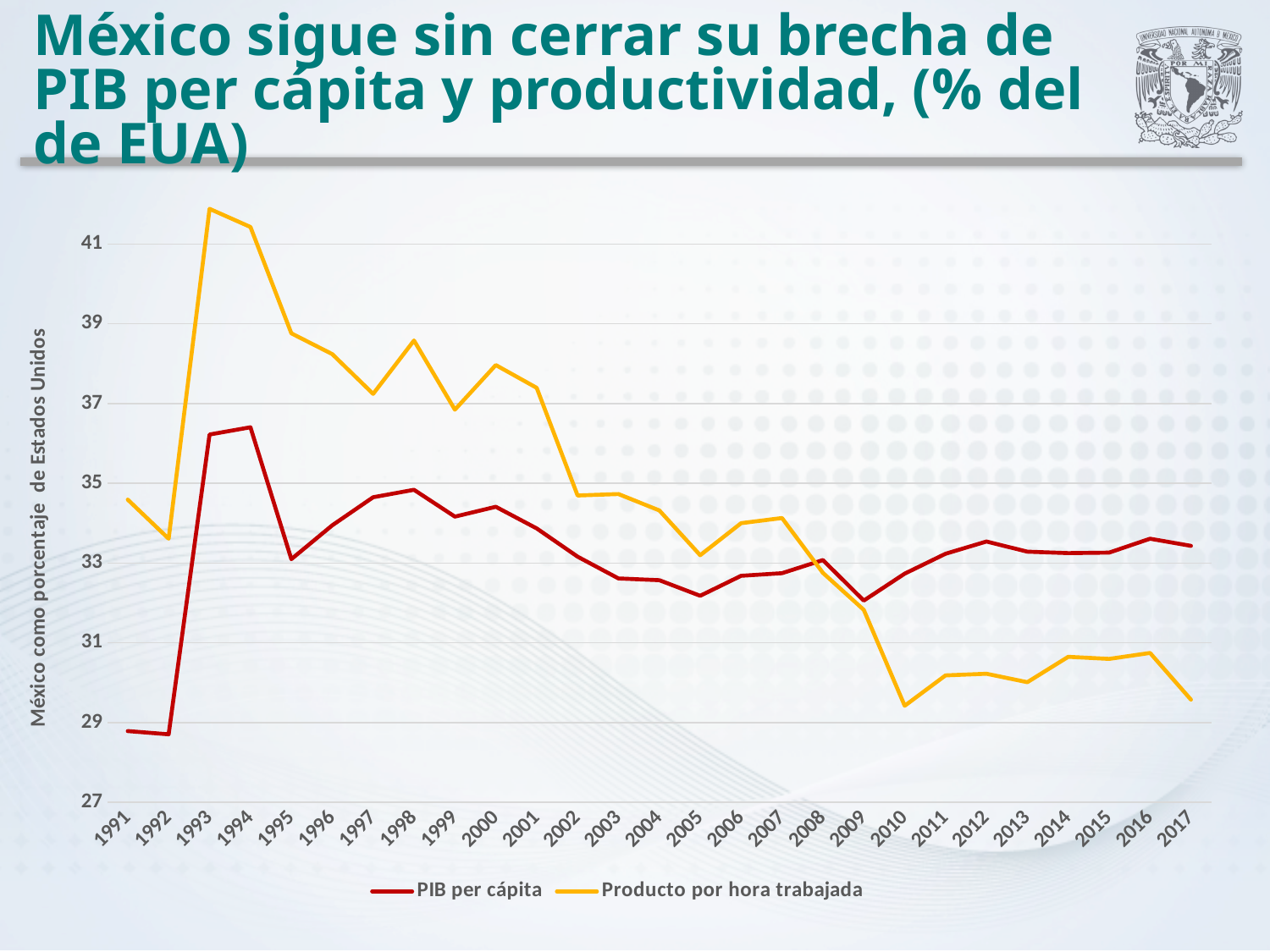
How many years are plotted along the x axis? 27 Is the value of PIB per cápita in 1991 greater or less than 29? less What kind of chart is shown on the slide? line chart How many series does the legend list? 2 Which colour is used for the PIB per cápita series? red Is the value of Producto por hora trabajada in 1993 greater or less than 41? greater In 1993, which series has the larger value, PIB per cápita or Producto por hora trabajada? Producto por hora trabajada In which year does the Producto por hora trabajada series reach its highest value? 1993 In 2017, which series has the larger value, PIB per cápita or Producto por hora trabajada? PIB per cápita Is the value of Producto por hora trabajada in 2017 greater or less than 31? less Does the Producto por hora trabajada series rise or fall overall between 1993 and 2010? fall